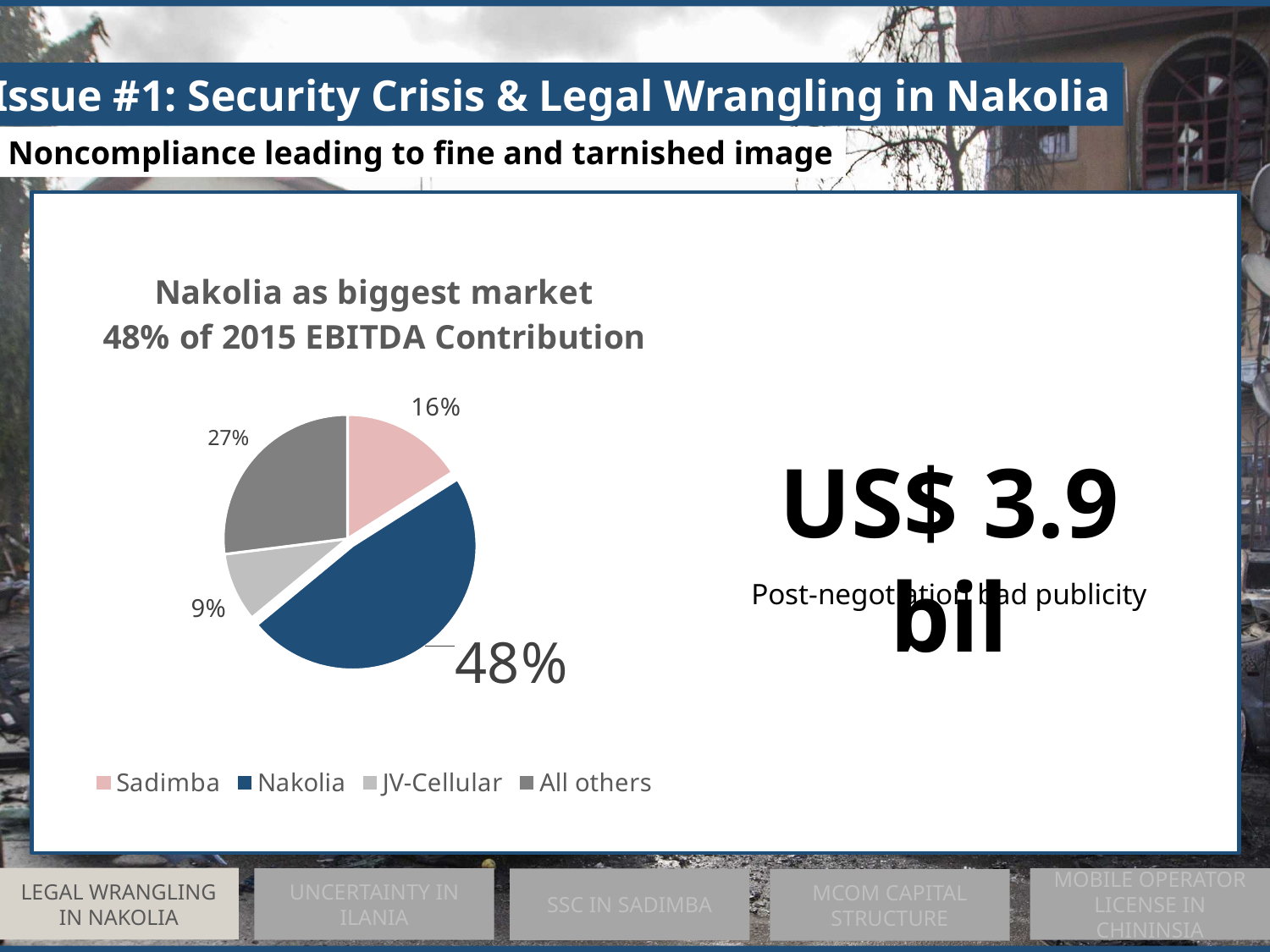
Which has a larger share of 2015 EBITDA contribution, Sadimba or All others? All others What share of 2015 EBITDA contribution does JV-Cellular account for? 9% What is the difference in percentage points between Nakolia's share and All others' share? 21 What share of 2015 EBITDA contribution does Nakolia account for? 48% Which market has the smallest share of 2015 EBITDA contribution? JV-Cellular What share of 2015 EBITDA contribution does All others account for? 27% What share of 2015 EBITDA contribution does Sadimba account for? 16% What is the title of the pie chart? Nakolia as biggest market 48% of 2015 EBITDA Contribution Which market has the largest share of 2015 EBITDA contribution? Nakolia How many entries does the chart legend list? 4 What type of chart is shown on the slide? pie chart How many slices does the pie chart have? 4